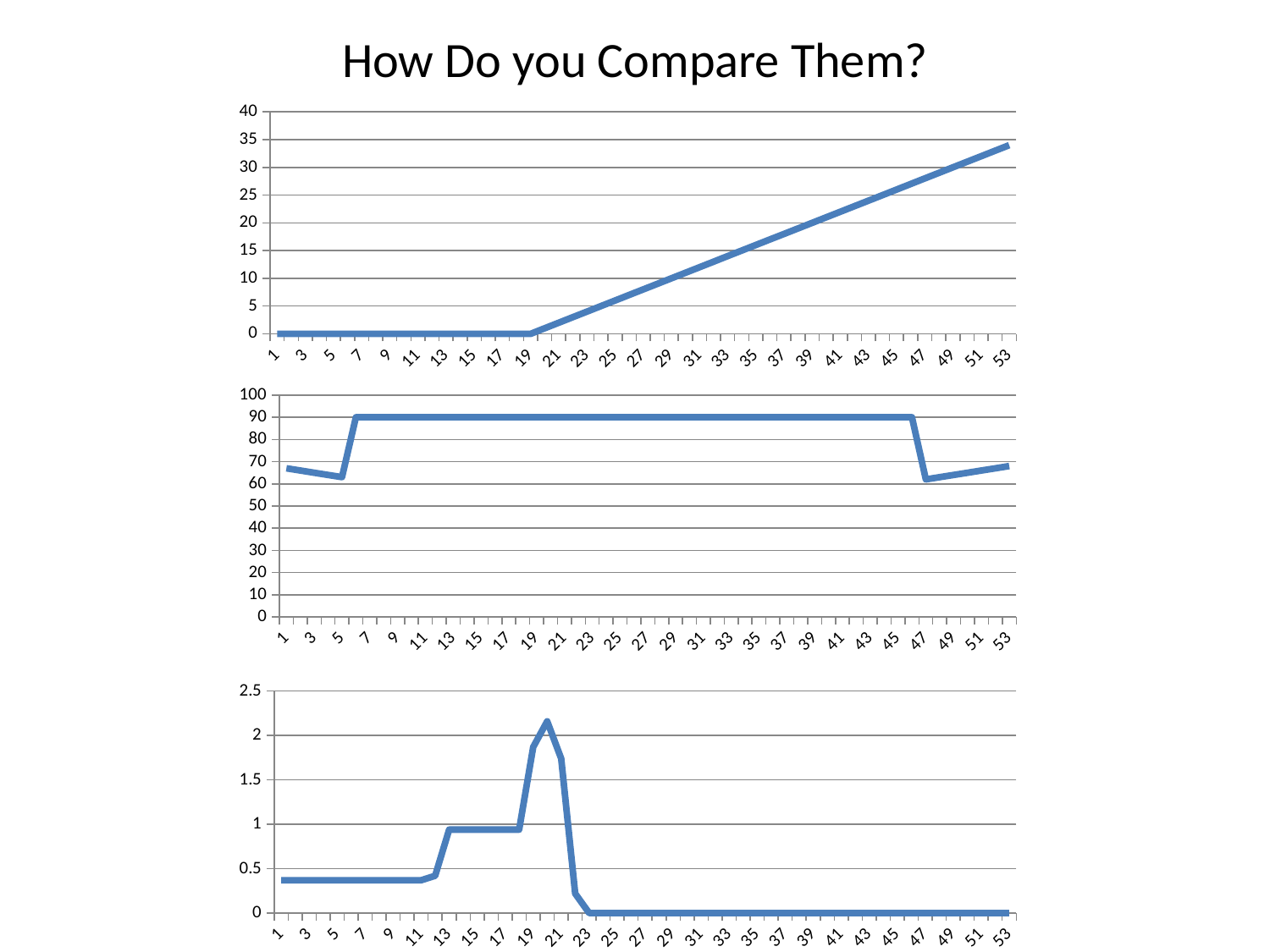
In the top chart, is the value at x = 53 greater or less than 30? greater What kind of chart is the top chart on the slide? line chart In the middle chart, which is larger: the value at x = 1 or the value at x = 5? x = 1 In the middle chart, what is the value at x = 20? 90 In the top chart, what is the value at x = 10? 0 In the bottom chart, is the value at x = 15 greater or less than 0.5? greater How many charts are shown on the slide? 3 In the middle chart, which is larger: the value at x = 30 or the value at x = 5? x = 30 In the bottom chart, what is the value at x = 40? 0 In the top chart, do the values rise or fall from x = 21 to x = 53? rise In the middle chart, is the value at x = 47 greater or less than 70? less